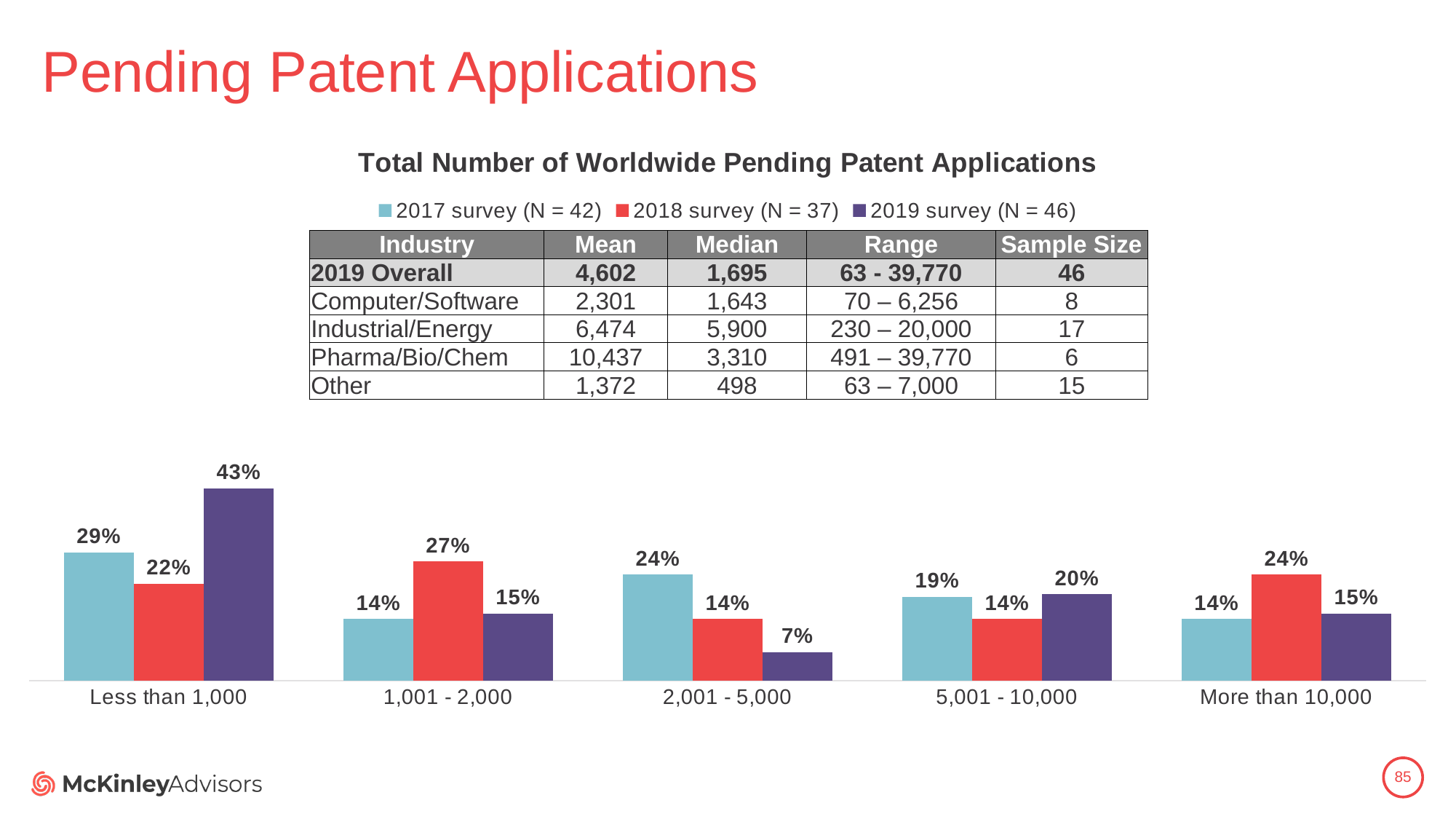
What is the value for the 2017 survey in the '2,001 - 5,000' category? 24% How many series does the chart legend list? 3 What is the value for the 2018 survey in the '1,001 - 2,000' category? 27% Which category has the highest value for the 2019 survey? Less than 1,000 What is the value for the 2019 survey in the 'Less than 1,000' category? 43% What kind of chart is shown on the slide? Bar chart What is the difference between the 2019 survey and 2018 survey values in the 'Less than 1,000' category? 21% Which is larger in the '5,001 - 10,000' category: the 2017 survey value or the 2019 survey value? 2019 survey What is the value for the 2019 survey in the '2,001 - 5,000' category? 7% Which category has the lowest value for the 2019 survey? 2,001 - 5,000 What is the title of the chart? Total Number of Worldwide Pending Patent Applications How many categories are shown on the x axis of the chart? 5